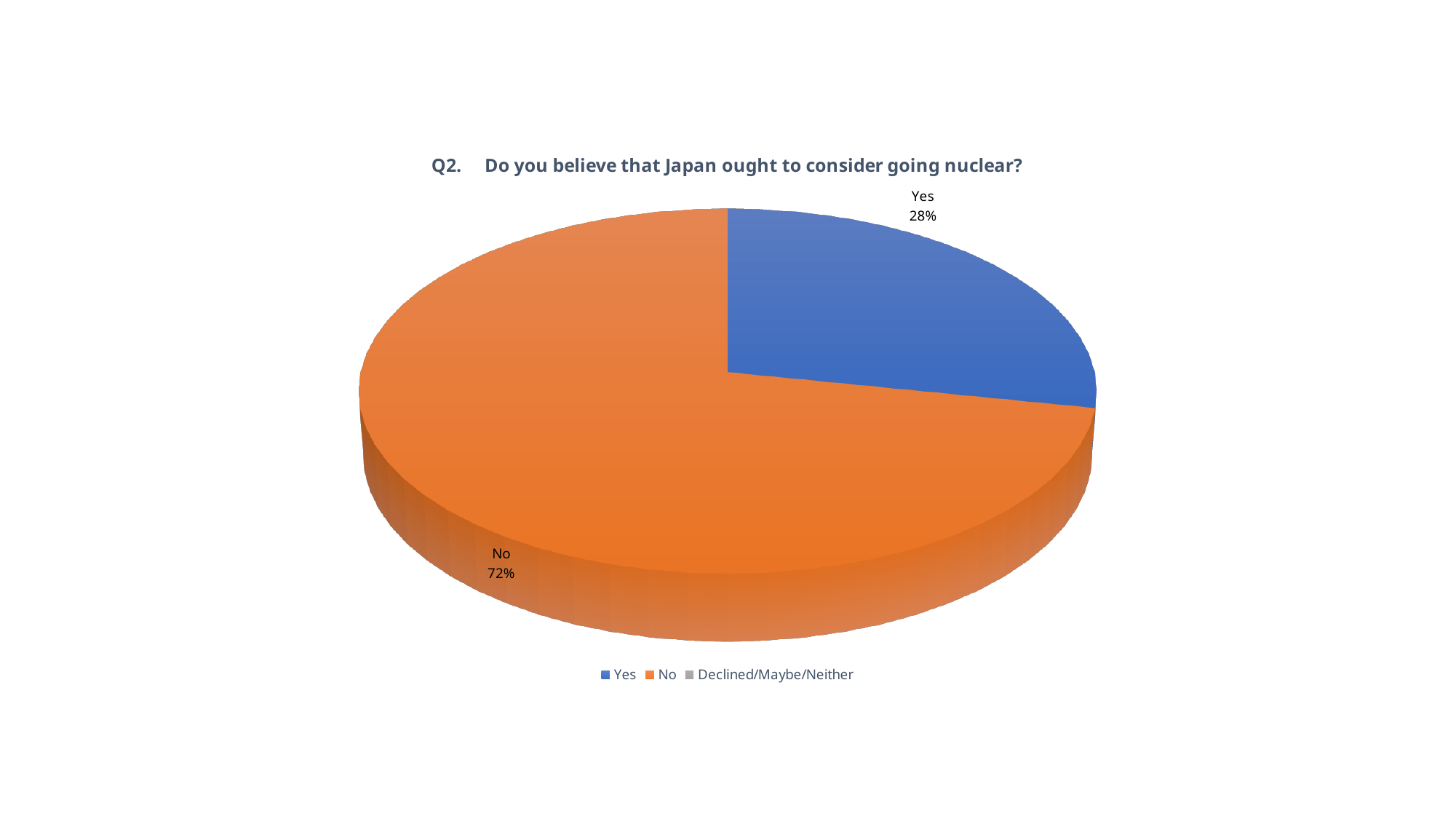
What is the title of the chart? Q2. Do you believe that Japan ought to consider going nuclear? Is the "No" slice larger or smaller than the "Yes" slice? larger Which response has the largest slice of the pie? No Is the "Yes" share greater or less than 50%? less What colour is the "No" slice? orange How many entries does the legend list? 3 By how many percentage points does the "No" share exceed the "Yes" share? 44 What share of the pie is labelled "No"? 72% What is the combined share of the "Yes" and "No" slices? 100% What kind of chart is shown on the slide? pie chart Which of the two labelled slices, Yes or No, is smaller? Yes What share of the pie is labelled "Yes"? 28%